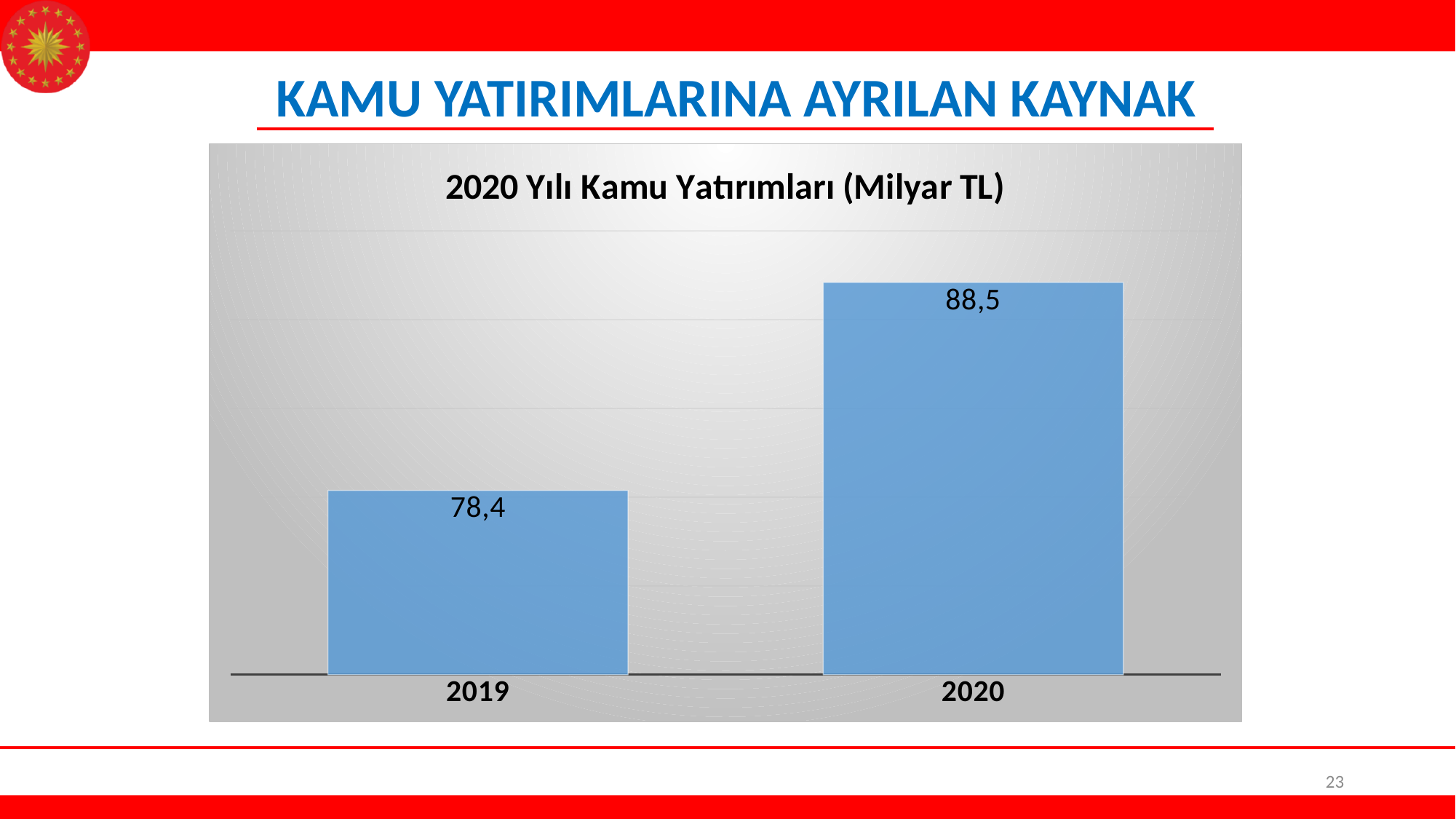
Which year has the highest value? 2020 What is the title of the chart? 2020 Yılı Kamu Yatırımları (Milyar TL) Do the values rise or fall from 2019 to 2020? Rise What is the value for 2020? 88,5 Which is larger, the value for 2019 or the value for 2020? 2020 What is the value for 2019? 78,4 How many categories are shown on the x axis? 2 What is the difference between the values for 2020 and 2019? 10,1 What kind of chart is shown on the slide? Bar chart Which year has the lowest value? 2019 What unit is given in the chart title? Milyar TL